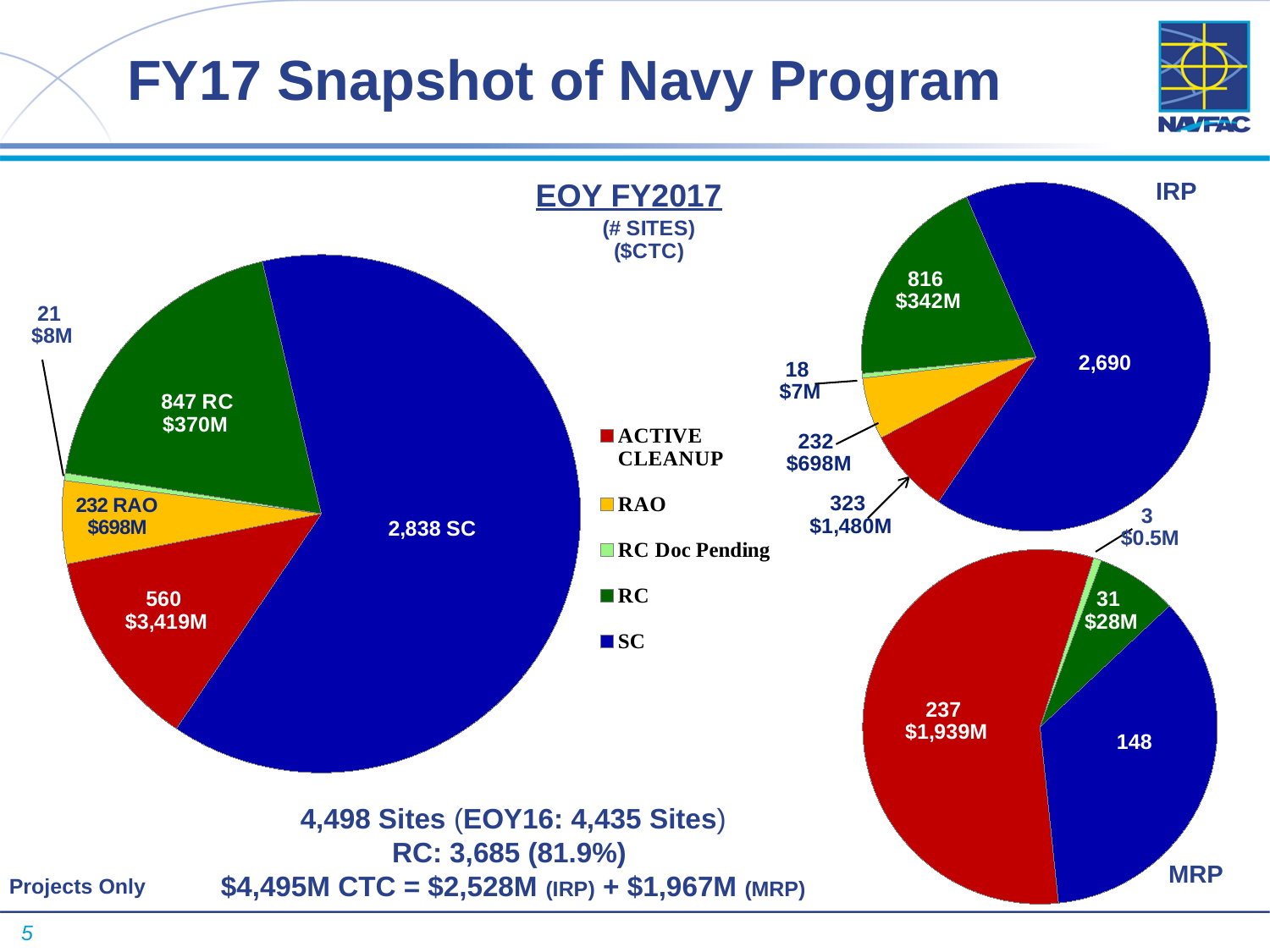
In the large EOY FY2017 pie chart, how many SC sites are shown? 2,838 In the large EOY FY2017 pie chart, what is the $CTC value for the ACTIVE CLEANUP slice (560 sites)? $3,419M In the large EOY FY2017 pie chart, which category has the most sites? SC (2,838) In the MRP pie chart, what is the $CTC value for the RC Doc Pending slice (3 sites)? $0.5M What colour represents RAO in the pie charts? Orange In the MRP pie chart, which has more sites: the ACTIVE CLEANUP slice (237) or the SC slice (148)? ACTIVE CLEANUP In the IRP pie chart, how many sites are in the RC slice and what is its $CTC? 816, $342M How many categories does the legend list? 5 In the large EOY FY2017 pie chart, which category has the fewest sites? RC Doc Pending (21) How many pie charts are on the slide? 3 In the large EOY FY2017 pie chart, what is the difference in site count between RC (847) and ACTIVE CLEANUP (560)? 287 What kind of charts are shown on the slide? Pie charts